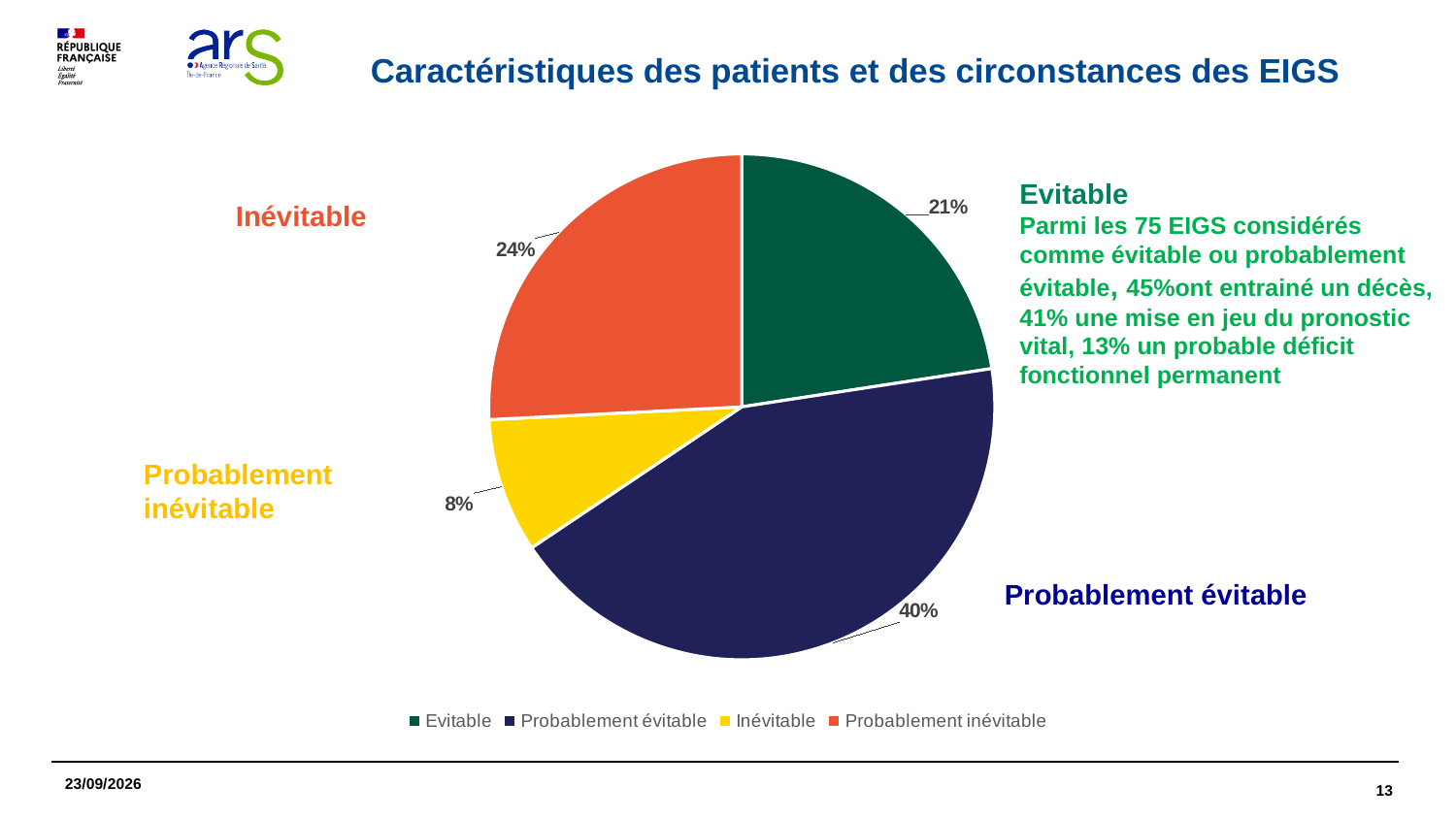
Which is larger, the Evitable slice or the Probablement évitable slice? Probablement évitable What percentage is shown for the Probablement évitable slice? 40% What is the difference between the Probablement évitable slice and the Evitable slice? 19% Which category has the largest slice of the pie chart? Probablement évitable How many entries does the legend of the pie chart list? 4 What is the smallest percentage shown on the pie chart? 8% How many slices does the pie chart have? 4 What percentage is shown on the orange slice of the pie chart? 24% What kind of chart is shown on the slide? pie chart What colour is the Evitable slice in the pie chart? green What percentage is shown on the yellow slice of the pie chart? 8% What percentage is shown for the Evitable slice? 21%